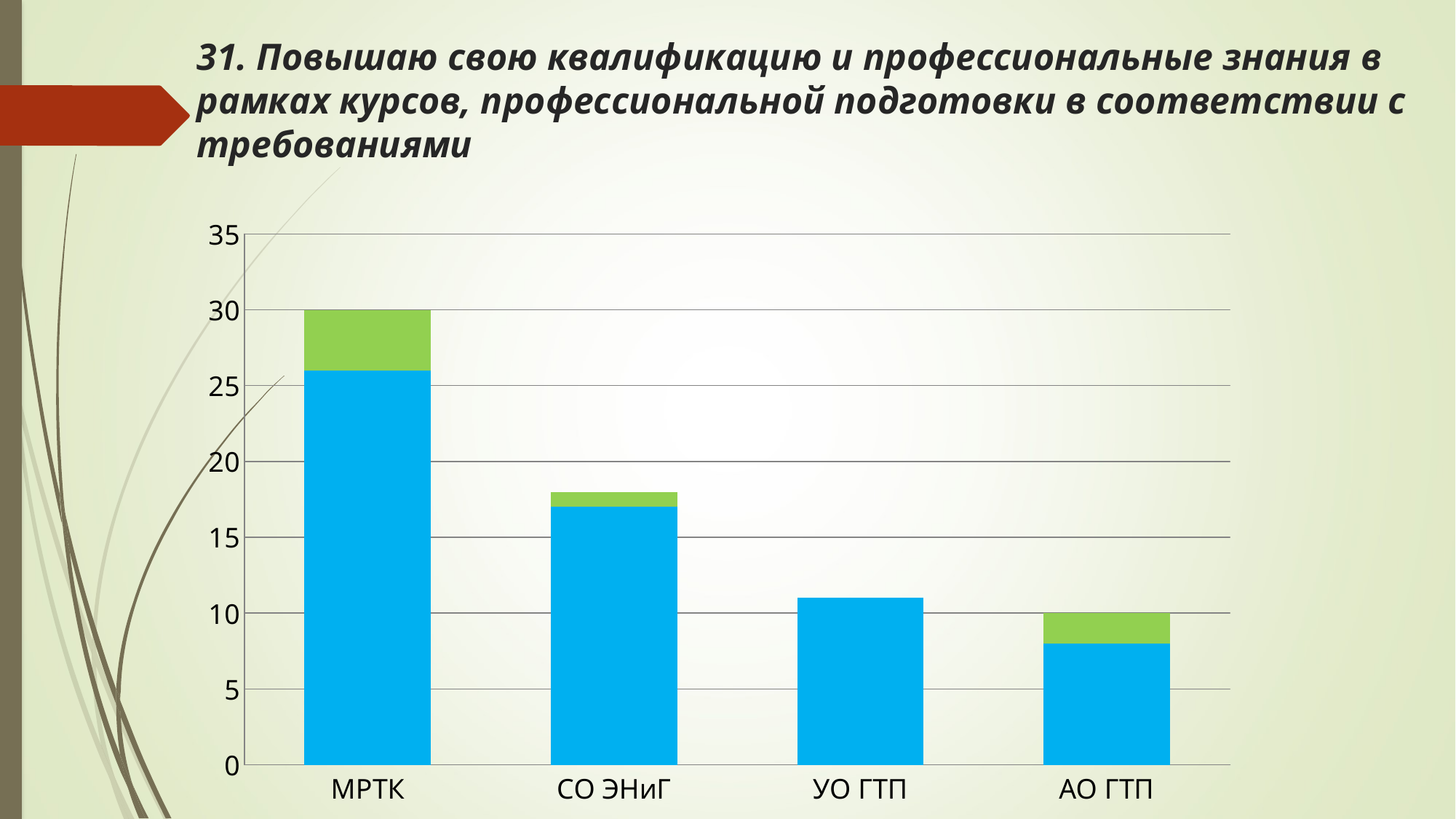
Which category has the tallest bar in the chart? МРТК What kind of chart is shown on the slide? bar chart How many categories are shown on the x axis of the chart? 4 Do the bar totals rise or fall from left to right along the x axis? fall What is the difference between the total bar heights for МРТК and АО ГТП? 20 What two colours are used for the segments of the stacked bars? blue and green What is the total height of the stacked bar for АО ГТП? 10 What is the total height of the stacked bar for МРТК? 30 Is the total value for СО ЭНиГ greater or less than 20? less Is the total value for СО ЭНиГ greater or less than 15? greater Is the value for УО ГТП greater or less than 15? less Which bar is taller, МРТК or СО ЭНиГ? МРТК